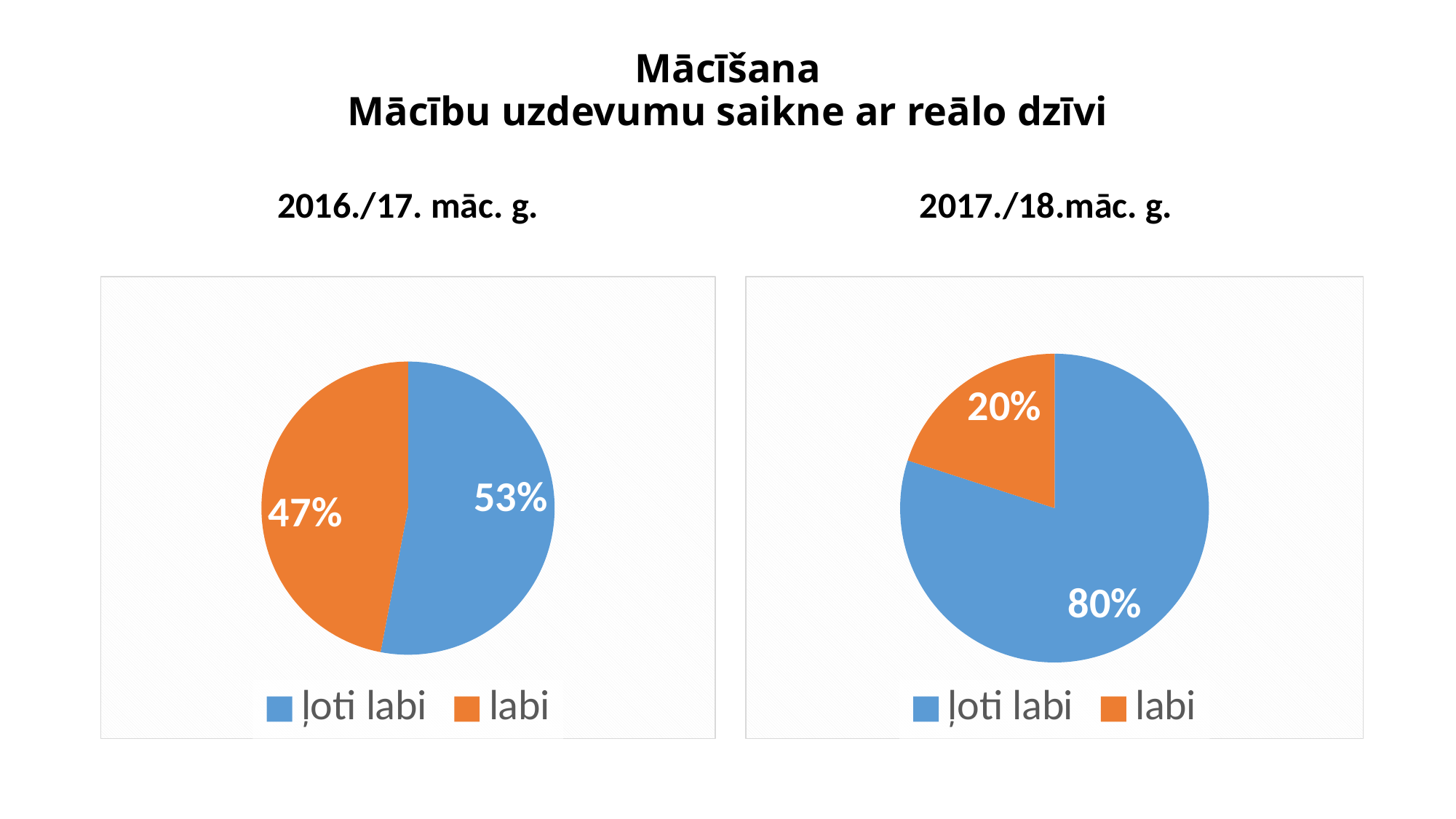
In the 2016./17. māc. g. chart, which category has the smallest slice? labi How many categories does the legend of the 2017./18.māc. g. chart list? 2 In the 2016./17. māc. g. chart, what is the difference between the ļoti labi and labi shares? 6% Which chart has the larger share for ļoti labi, 2016./17. māc. g. or 2017./18.māc. g.? 2017./18.māc. g. In the 2017./18.māc. g. chart, what is the difference between the ļoti labi and labi shares? 60% In the 2017./18.māc. g. chart, what share is labelled for ļoti labi? 80% In the 2017./18.māc. g. chart, which category has the largest slice? ļoti labi In the 2017./18.māc. g. chart, what share is labelled for labi? 20% In the 2016./17. māc. g. chart, what share is labelled for ļoti labi? 53% In the 2016./17. māc. g. chart, what share is labelled for labi? 47% What kind of chart is the 2016./17. māc. g. chart? pie chart In the 2016./17. māc. g. chart, what colour is the labi slice? orange